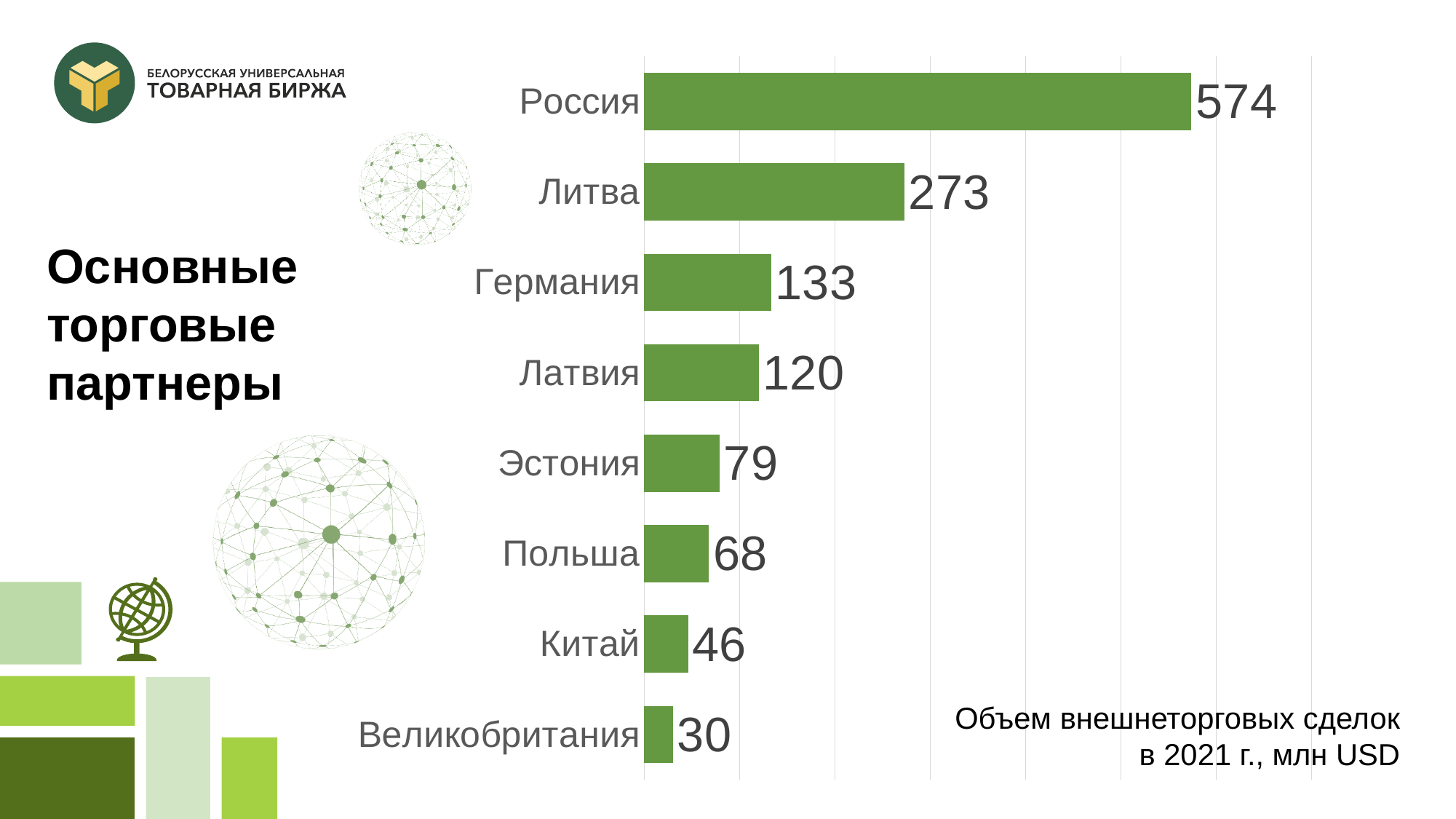
Which country has the highest value? Россия What is the value for Германия? 133 What unit is stated for the values in the chart? млн USD What is the value for Китай? 46 How many countries are shown in the chart? 8 Do the values rise or fall going from the top bar to the bottom bar? Fall Which country has the lowest value? Великобритания What kind of chart is shown on the slide? Bar chart What is the value for Россия? 574 What is the difference between the values for Германия and Латвия? 13 What is the difference between the values for Россия and Литва? 301 Which is larger, the value for Эстония or the value for Польша? Эстония